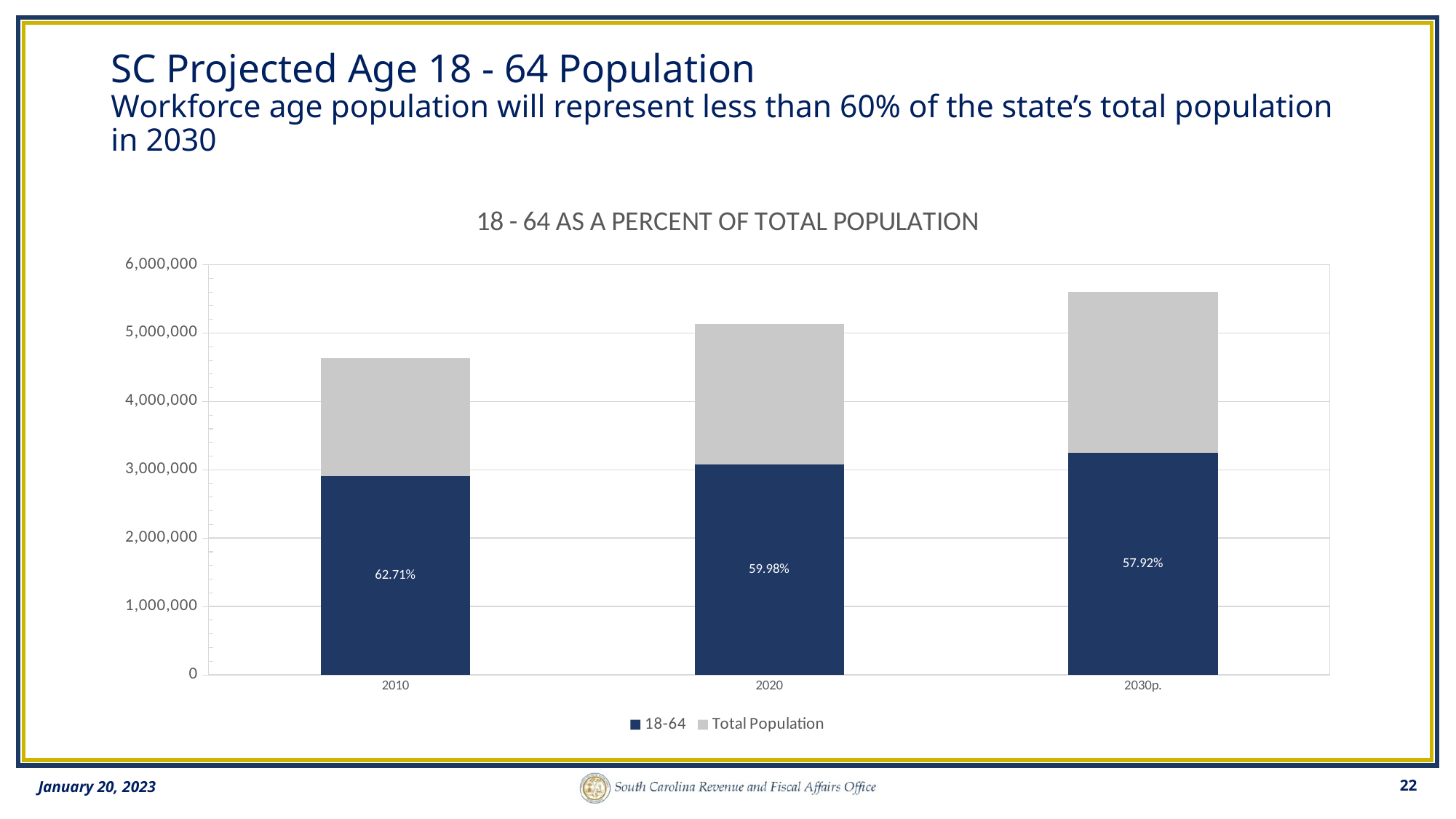
Is the 18-64 share of total population larger in 2020 or in 2030p.? 2020 What percentage label is shown on the 2020 bar? 59.98% What percentage label is shown on the 2010 bar? 62.71% Is the total population bar for 2010 greater or less than 5,000,000? less What percentage label is shown on the 2030p. bar? 57.92% Which year has the highest 18-64 share of total population? 2010 Which year has the lowest 18-64 share of total population? 2030p. How many years are shown on the x axis? 3 Is the total population bar for 2030p. greater or less than 5,000,000? greater By how many percentage points does the 18-64 share fall from 2010 to 2030p.? 4.79 How many series does the legend list? 2 Does the 18-64 share of total population rise or fall from 2010 to 2030p.? fall